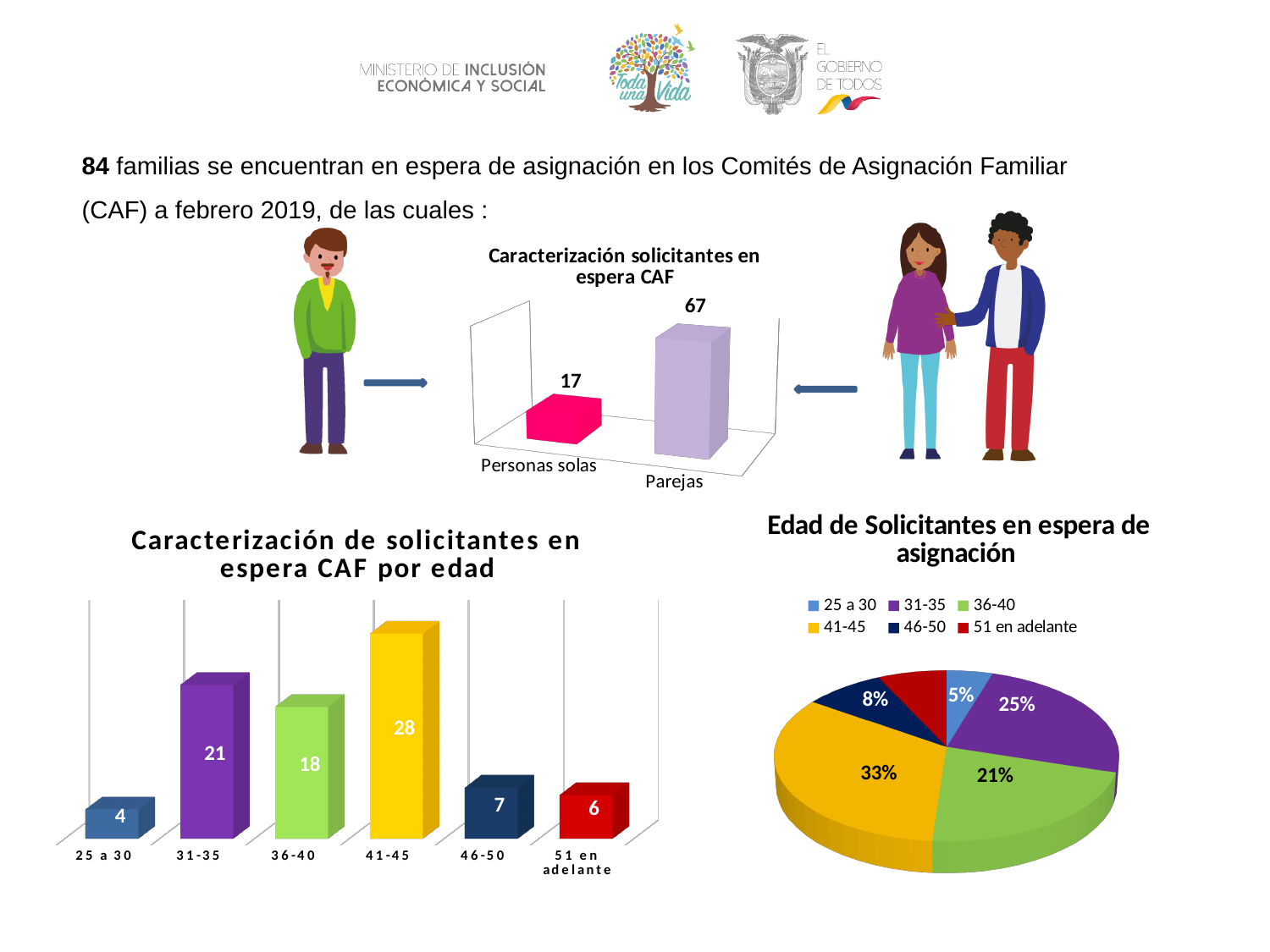
In the chart titled 'Caracterización de solicitantes en espera CAF por edad', which age group has the highest value? 41-45 In the chart titled 'Caracterización de solicitantes en espera CAF por edad', how many age categories are shown? 6 What kind of chart is 'Edad de Solicitantes en espera de asignación'? Pie chart In the chart titled 'Caracterización solicitantes en espera CAF', what is the value for Personas solas? 17 In the chart titled 'Edad de Solicitantes en espera de asignación', how many entries does the legend list? 6 In the chart titled 'Caracterización solicitantes en espera CAF', what is the difference between Parejas and Personas solas? 50 In the chart titled 'Caracterización de solicitantes en espera CAF por edad', which age group has the lowest value? 25 a 30 In the chart titled 'Edad de Solicitantes en espera de asignación', what share does the 41-45 slice have? 33% In the chart titled 'Caracterización de solicitantes en espera CAF por edad', what is the value for 41-45? 28 In the chart titled 'Caracterización de solicitantes en espera CAF por edad', which is larger, 46-50 or 51 en adelante? 46-50 In the chart titled 'Caracterización solicitantes en espera CAF', what is the value for Parejas? 67 In the chart titled 'Caracterización de solicitantes en espera CAF por edad', what is the difference between 31-35 and 36-40? 3